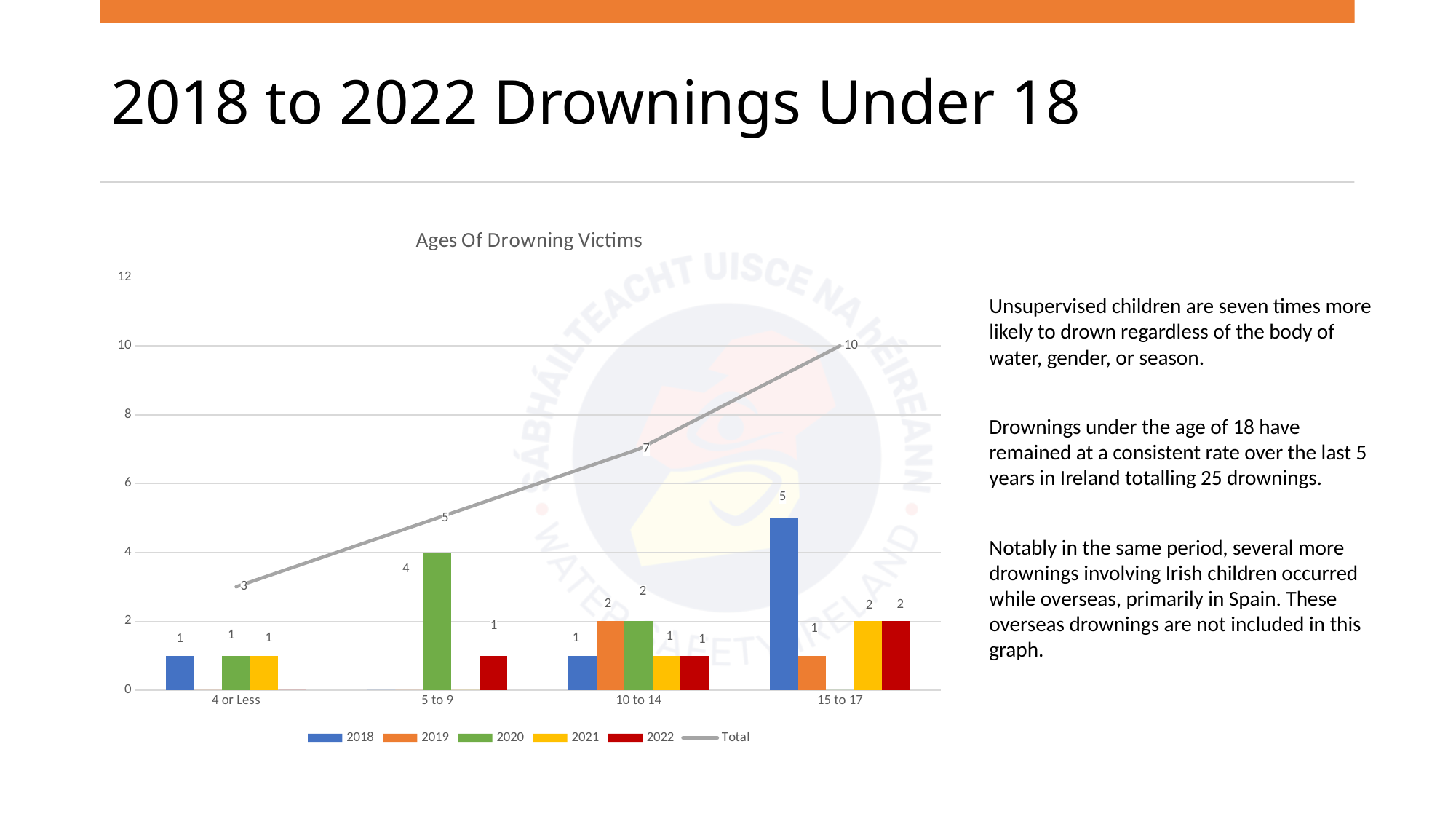
How many age categories are shown on the x axis? 4 What is the 2018 value for the 15 to 17 age group? 5 What is the difference between the Total for 15 to 17 and the Total for 10 to 14? 3 What is the title of the chart? Ages Of Drowning Victims Which age group has the lowest Total value? 4 or Less What is the Total value for the 15 to 17 age group? 10 What is the Total value for the 4 or Less age group? 3 Which age group has the highest Total value? 15 to 17 Which is larger: the 2019 value for 10 to 14 or the 2019 value for 15 to 17? 10 to 14 Does the Total line rise or fall from 4 or Less to 15 to 17? rise How many series does the chart legend list? 6 What is the 2020 value for the 5 to 9 age group? 4